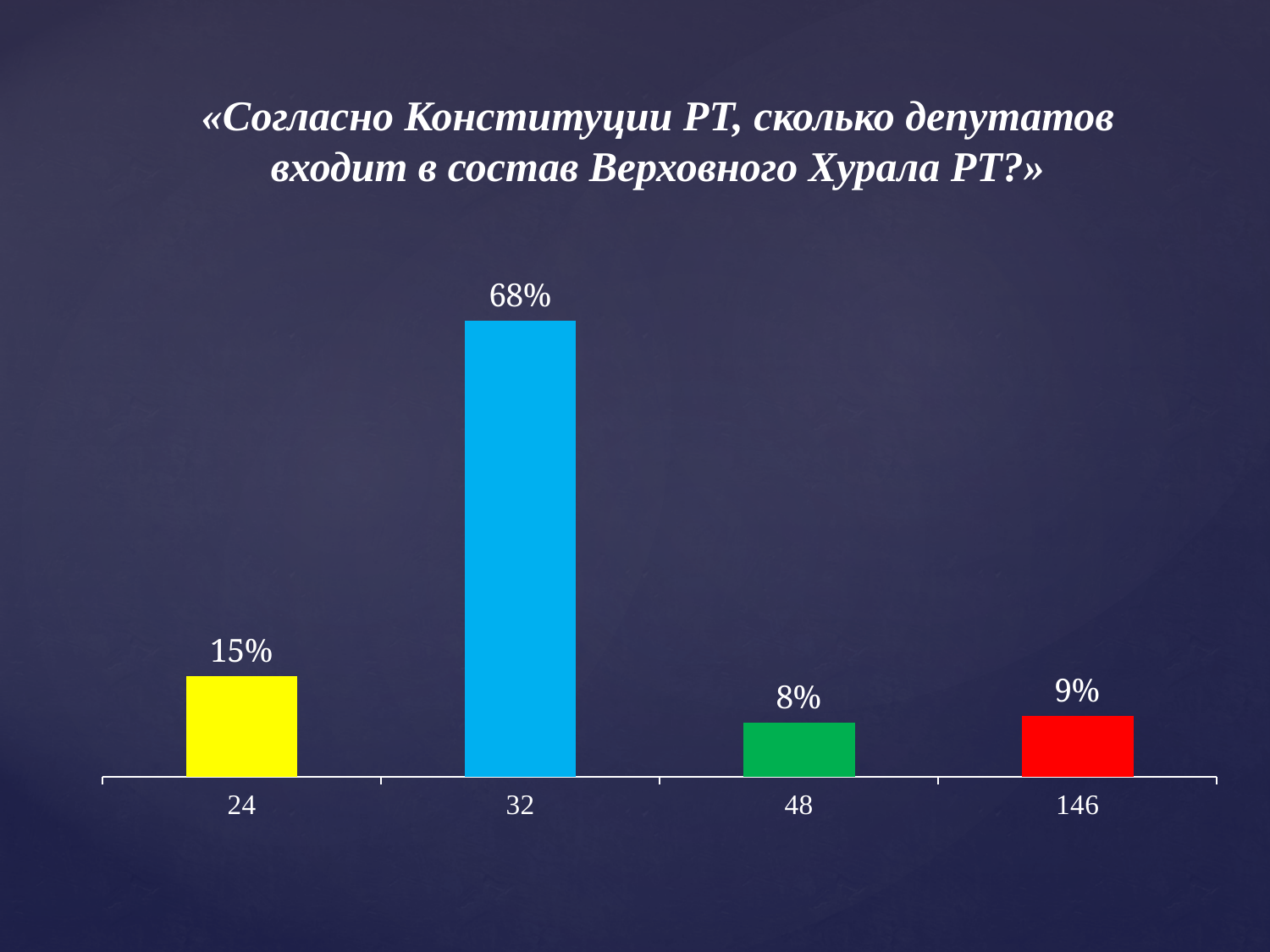
What colour is the bar for the answer "32"? Blue What percentage of respondents answered "32"? 68% Which answer option received the highest share of responses? 32 What percentage of respondents answered "24"? 15% What type of chart is shown on the slide? Bar chart What is the difference in percentage points between the share for "32" and the share for "24"? 53 Which answer option received the lowest share of responses? 48 What percentage of respondents answered "48"? 8% What is the difference in percentage points between the share for "146" and the share for "48"? 1 What percentage of respondents answered "146"? 9% How many answer options (bars) are shown in the chart? 4 Which received a larger share of responses, "24" or "146"? 24